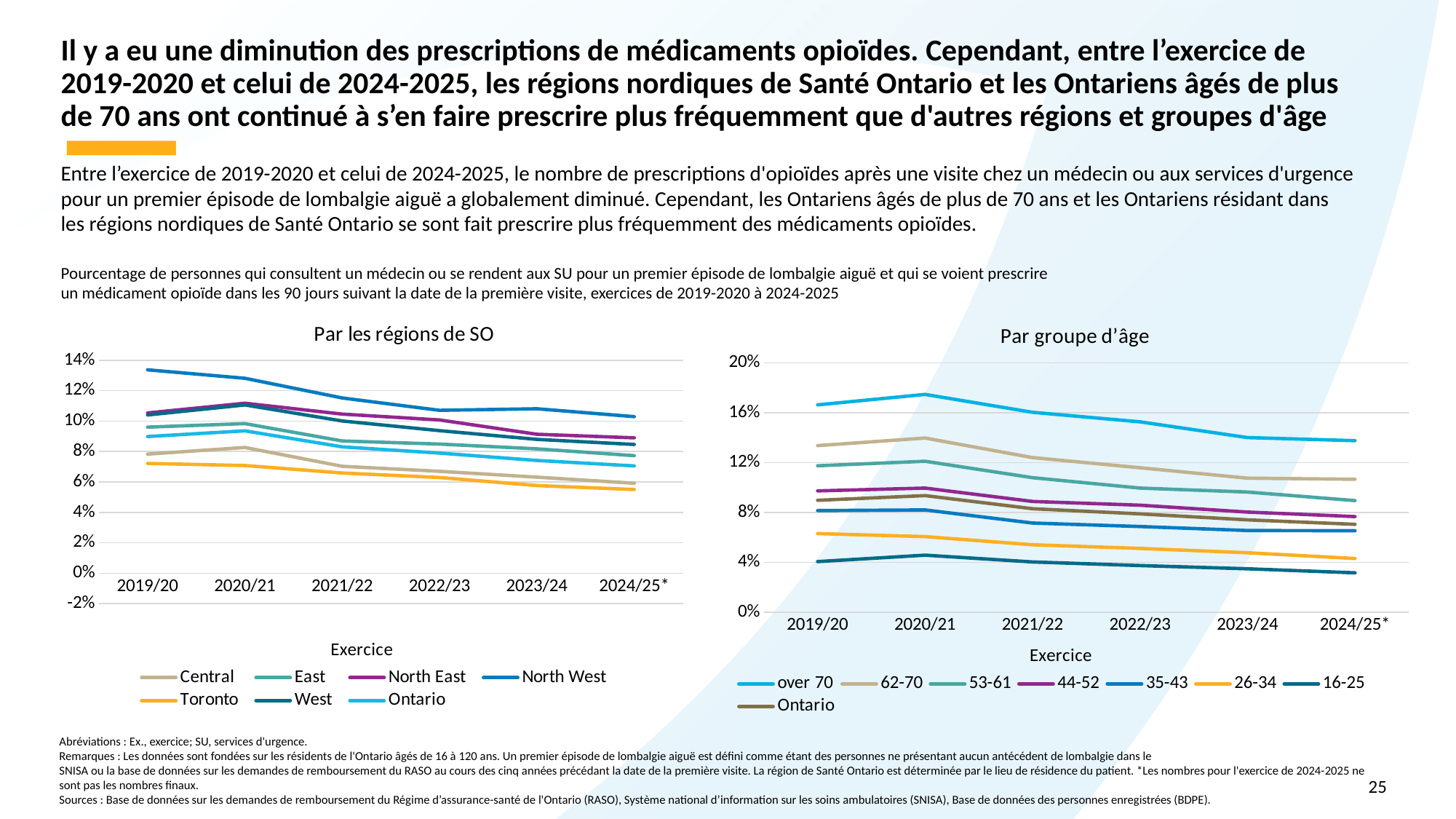
In the chart titled "Par groupe d'âge", does the over 70 line rise or fall between 2020/21 and 2024/25*? fall In the chart titled "Par les régions de SO", which is larger in 2024/25*: North West or Toronto? North West How many fiscal years are shown on the x axis of the chart titled "Par groupe d'âge"? 6 How many series does the legend of the chart titled "Par groupe d'âge" list? 8 In the chart titled "Par groupe d'âge", is the value for over 70 in 2020/21 greater or less than 16%? greater What kind of chart is the chart titled "Par les régions de SO"? line chart How many series does the legend of the chart titled "Par les régions de SO" list? 7 In the chart titled "Par les régions de SO", is the value for North West in 2019/20 greater or less than 12%? greater In the chart titled "Par les régions de SO", which region has the highest value in 2019/20? North West In the chart titled "Par groupe d'âge", which age group has the highest value in 2020/21? over 70 In the chart titled "Par les régions de SO", which region has the lowest value in 2024/25*? Toronto In the chart titled "Par groupe d'âge", which age group has the lowest value in 2024/25*? 16-25